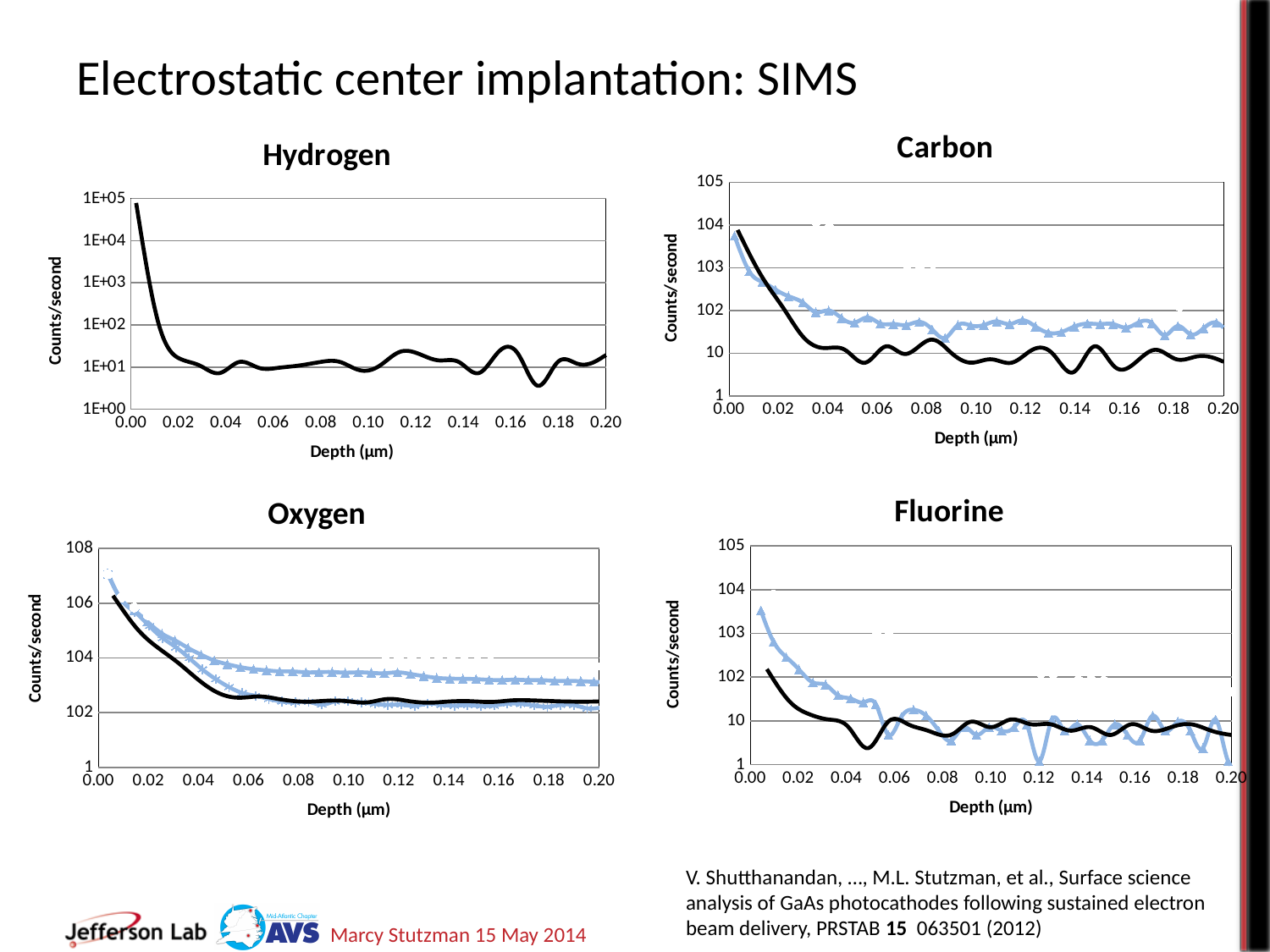
In the Carbon chart, which line is higher at depth 0.10, the blue marked line or the black line? the blue marked line In the Hydrogen chart, is the value at depth 0.10 greater or less than 1E+02? less What is the y-axis title of the Oxygen chart? Counts/second In the Hydrogen chart, is the value at depth 0.00 greater or less than 1E+04? greater How many charts are shown on the slide? 4 In the Oxygen chart, do the values of the black line rise or fall as depth increases from 0.00 to 0.06 µm? fall What kind of chart is the Hydrogen chart? line chart What is the x-axis title of the Carbon chart? Depth (µm) In the Fluorine chart, is the blue marked line at depth 0.00 greater or less than 10^3? greater In the Hydrogen chart, do the values rise or fall as depth increases from 0.00 to 0.02 µm? fall